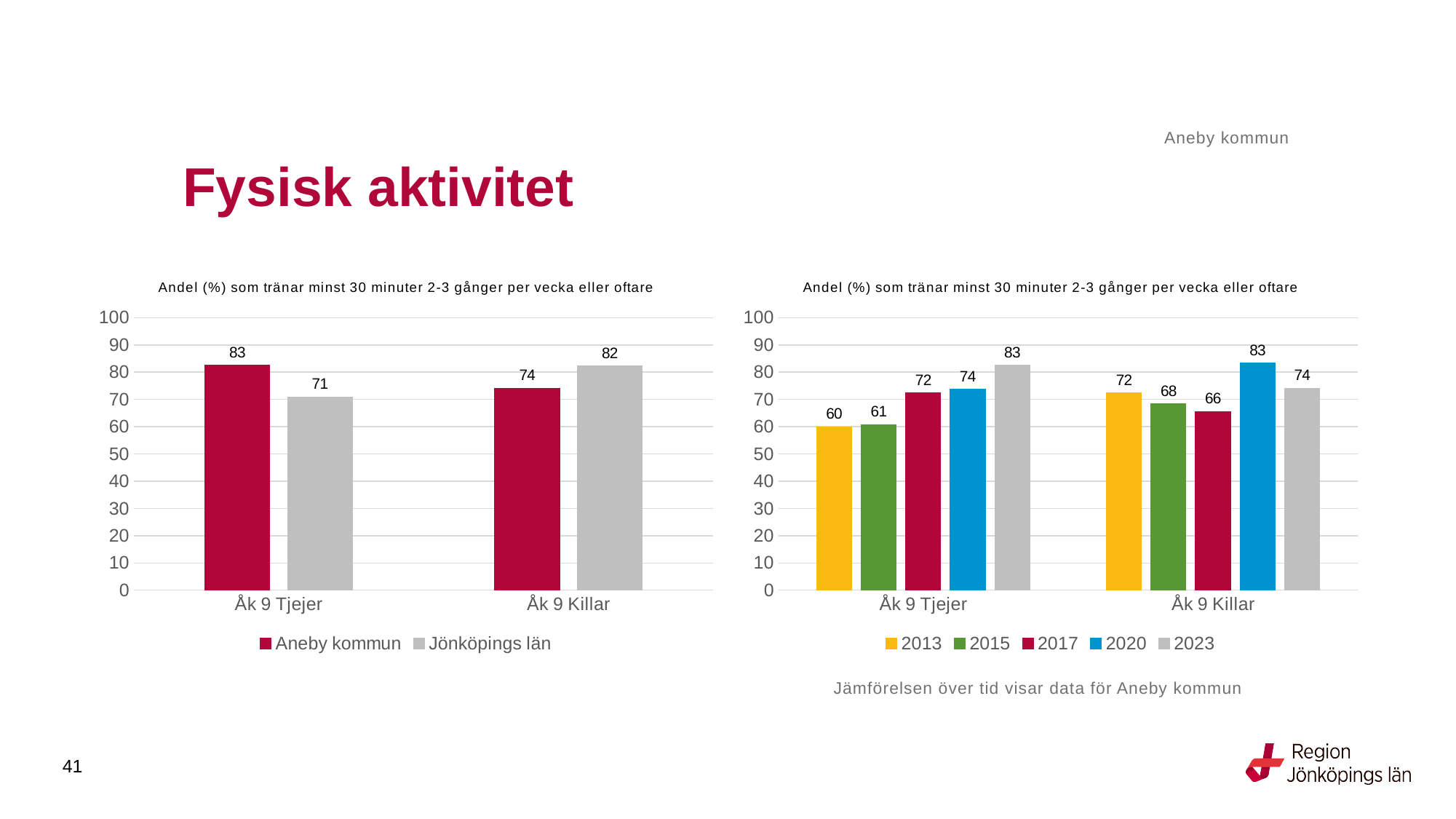
In the left chart, how many series does the legend list? 2 What type of chart is the right chart? Bar chart In the left chart, what is the value for Aneby kommun for Åk 9 Tjejer? 83 In the left chart, what is the difference between Aneby kommun and Jönköpings län for Åk 9 Tjejer? 12 In the right chart, what is the difference between the 2023 and 2013 values for Åk 9 Tjejer? 23 In the right chart, how many series does the legend list? 5 In the right chart, what is the value for 2013 for Åk 9 Tjejer? 60 In the right chart, what is the value for 2020 for Åk 9 Killar? 83 In the right chart, which year has the lowest value for Åk 9 Killar? 2017 In the left chart, which is larger for Åk 9 Killar: Aneby kommun or Jönköpings län? Jönköpings län In the left chart, what is the value for Jönköpings län for Åk 9 Killar? 82 In the right chart, which year has the highest value for Åk 9 Tjejer? 2023